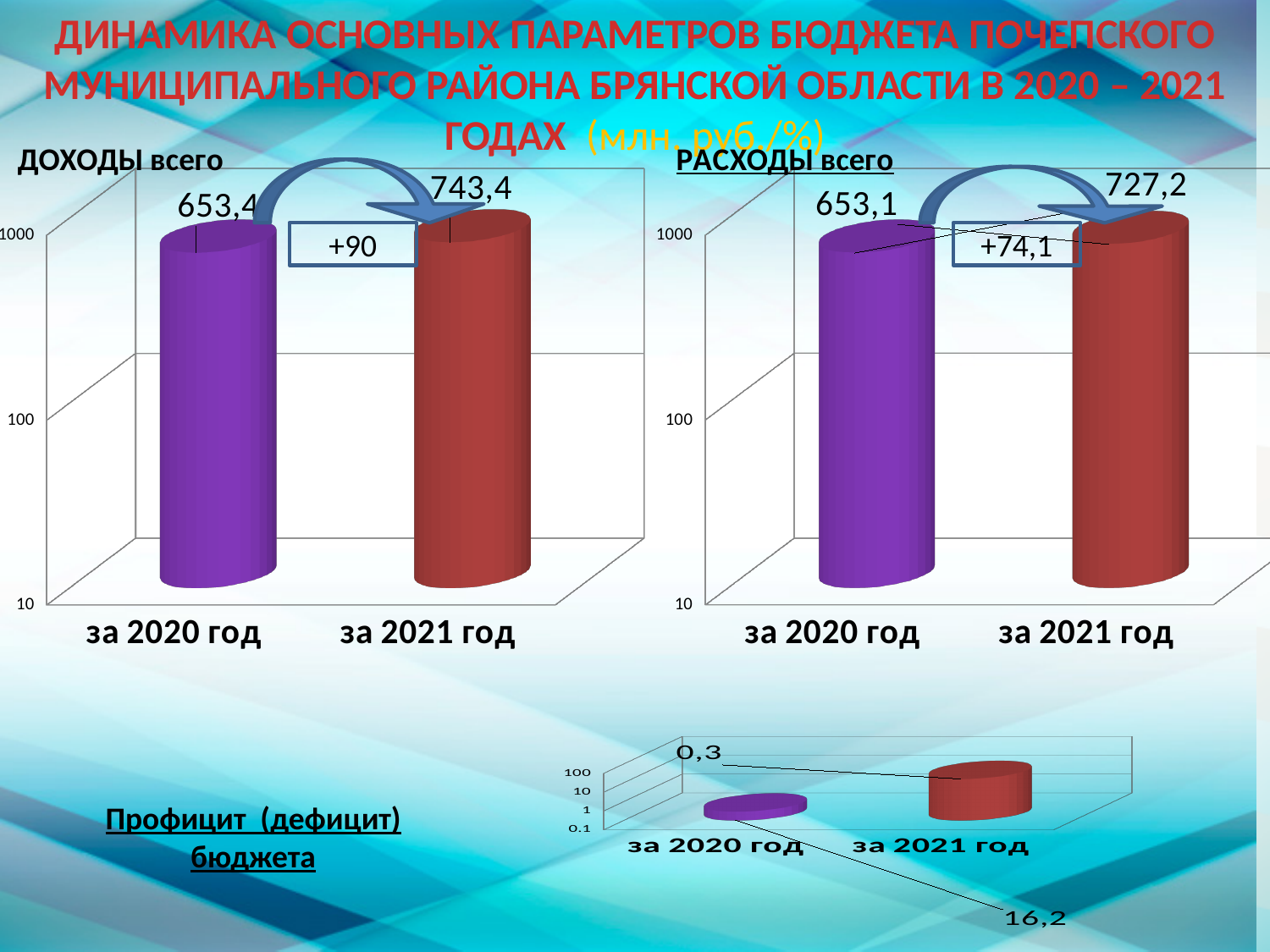
In the РАСХОДЫ всего chart, which year has the higher value? за 2021 год In the РАСХОДЫ всего chart, what is the value for за 2020 год? 653,1 In the ДОХОДЫ всего chart, what is the difference between the 2021 and 2020 values? 90 In the РАСХОДЫ всего chart, what is the difference between the 2021 and 2020 values? 74,1 In the ДОХОДЫ всего chart, which year has the lower value? за 2020 год What kind of chart is the ДОХОДЫ всего chart? bar chart In the ДОХОДЫ всего chart, do the values rise or fall from 2020 to 2021? rise In the Профицит (дефицит) бюджета chart at the bottom, which year has the taller bar? за 2021 год In the ДОХОДЫ всего chart, what is the value for за 2021 год? 743,4 In the РАСХОДЫ всего chart, what is the value for за 2021 год? 727,2 In the ДОХОДЫ всего chart, what is the value for за 2020 год? 653,4 How many categories are shown in the РАСХОДЫ всего chart? 2